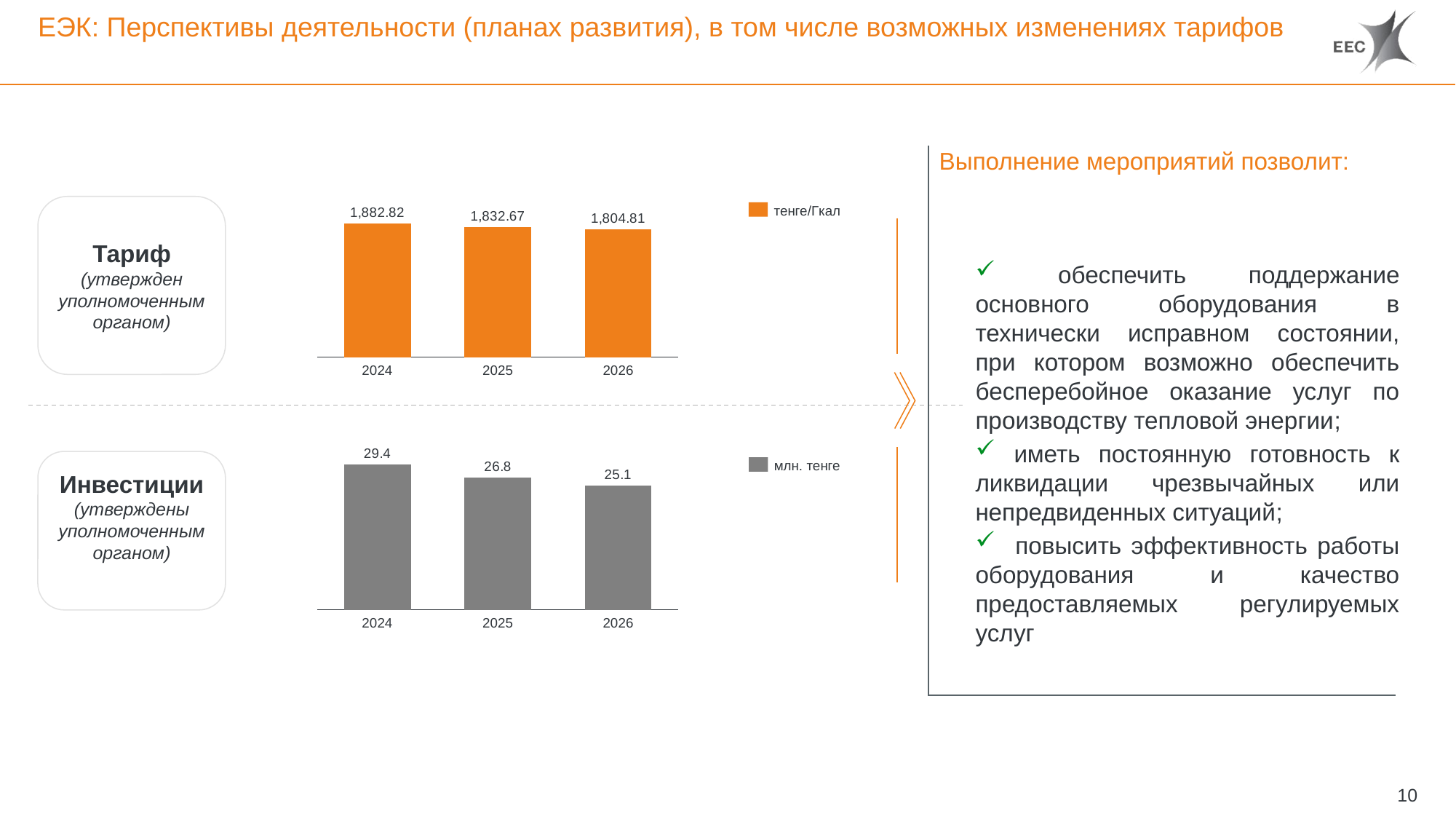
In the bottom chart (Инвестиции), which is larger: the value for 2024 or the value for 2025? 2024 In the top chart (Тариф), what is the difference between the 2024 and 2025 values? 50.15 In the bottom chart (Инвестиции), what is the difference between the 2024 and 2026 values? 4.2 What type of chart is the bottom chart (Инвестиции)? Bar chart In the bottom chart (Инвестиции), what is the value for 2025? 26.8 In the top chart (Тариф), what is the value for 2024? 1,882.82 What unit does the legend of the bottom chart (Инвестиции) show? млн. тенге In the top chart (Тариф), what is the value for 2026? 1,804.81 In the top chart (Тариф), which year has the highest value? 2024 How many years are shown on the x axis of the top chart (Тариф)? 3 In the top chart (Тариф), do the values rise or fall from 2024 to 2026? Fall In the bottom chart (Инвестиции), which year has the lowest value? 2026